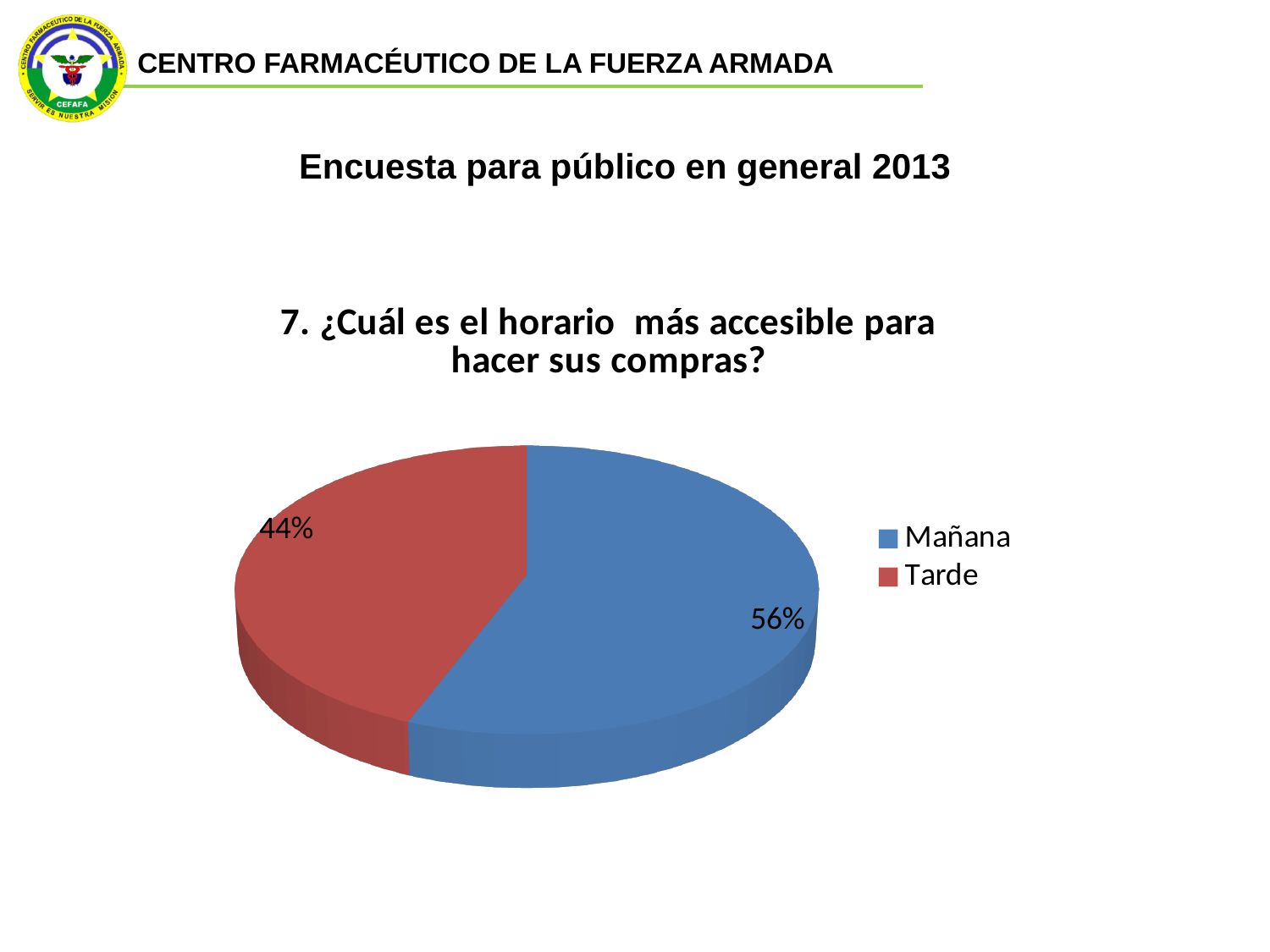
What is the total of the two slices shown in the pie chart? 100% What percentage of respondents chose Tarde? 44% What kind of chart is shown on the slide? Pie chart What is the difference in percentage points between Mañana and Tarde? 12 Which time slot has the smallest share of the pie? Tarde What colour is the slice for Tarde? Red Which time slot has the largest share of the pie? Mañana What is the title of the chart? 7. ¿Cuál es el horario más accesible para hacer sus compras? Which is larger, the share for Mañana or the share for Tarde? Mañana How many entries does the legend list? 2 How many categories does the pie chart show? 2 What percentage of respondents chose Mañana as the most accessible time for shopping? 56%